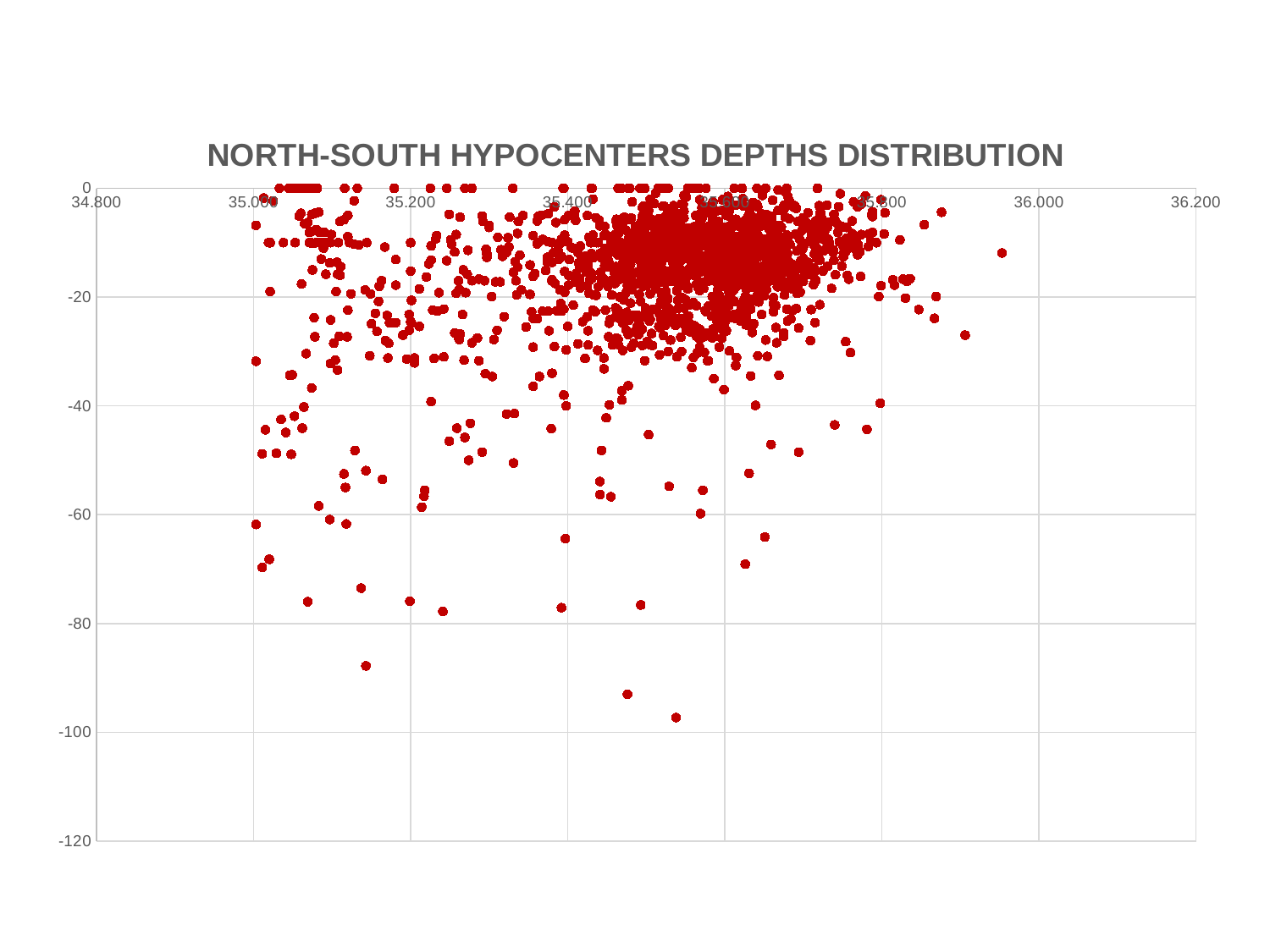
Is the vertical value of the deepest (lowest) point in the chart greater or less than -80? less Is the horizontal value of the rightmost point in the chart greater or less than 35.800? greater What is the title of the chart? NORTH-SOUTH HYPOCENTERS DEPTHS DISTRIBUTION What kind of chart is shown on the slide? scatter chart Is the vertical value of the deepest (lowest) point in the chart greater or less than -100? greater What colour are the plotted points in the chart? red